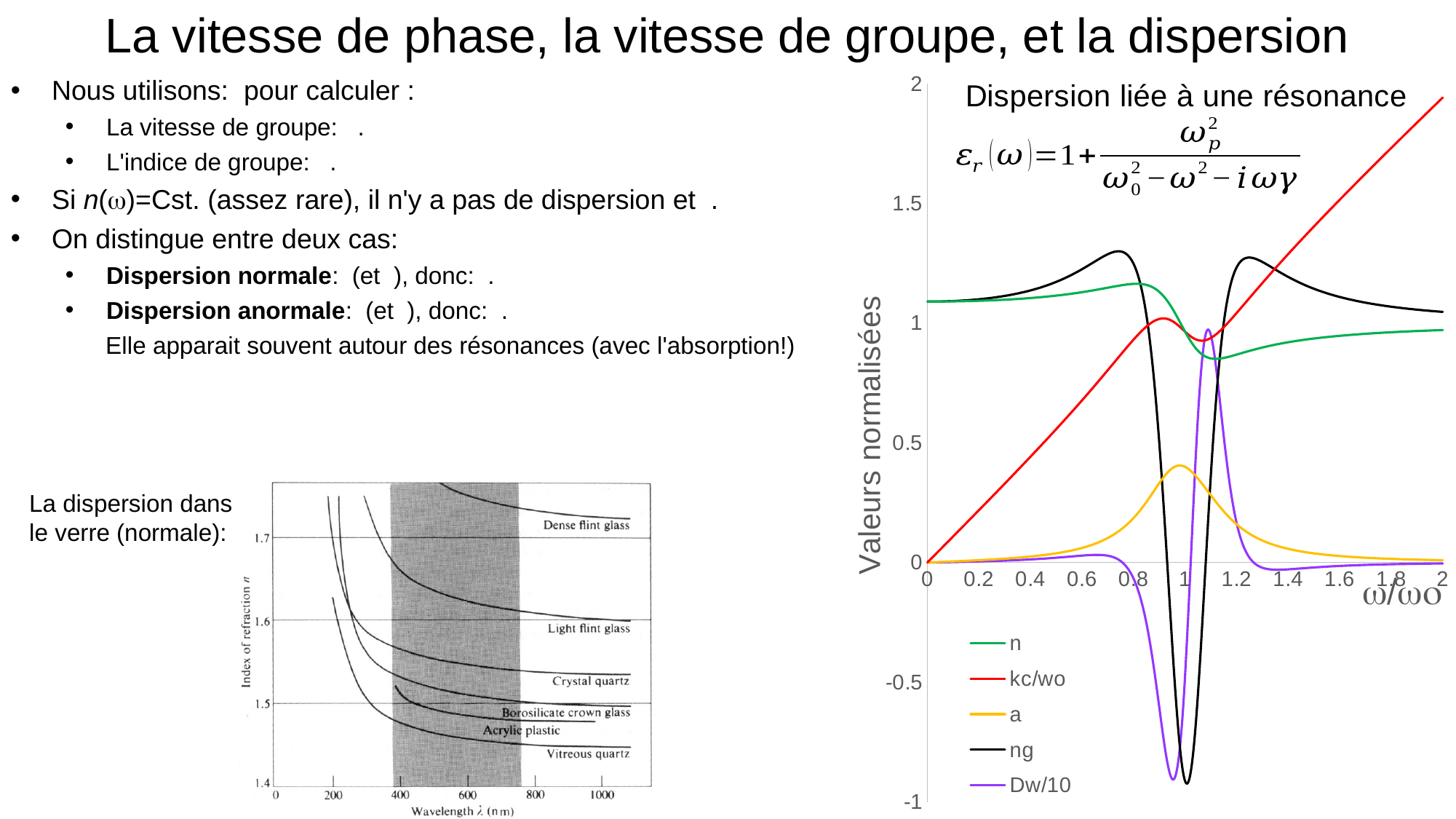
What kind of chart is the chart titled 'Dispersion liée à une résonance'? line chart In the bottom-left chart of index of refraction versus wavelength, does the index of refraction of Dense flint glass rise or fall as wavelength increases? fall In the chart titled 'Dispersion liée à une résonance', is the value of kc/wo at ω/ωo = 2 greater or less than 1.5? greater In the bottom-left chart of index of refraction versus wavelength, is the index of refraction of Vitreous quartz at 600 nm greater or less than 1.5? less In the chart titled 'Dispersion liée à une résonance', what colour is the ng series drawn in? black In the chart titled 'Dispersion liée à une résonance', does the kc/wo series rise or fall between ω/ωo = 0 and ω/ωo = 0.8? rise In the bottom-left chart of index of refraction versus wavelength, how many labelled material curves are shown? 6 In the chart titled 'Dispersion liée à une résonance', is the value of a at ω/ωo = 1 greater or less than 0.5? less In the chart titled 'Dispersion liée à une résonance', what is the label of the vertical axis? Valeurs normalisées In the chart titled 'Dispersion liée à une résonance', which series reaches the highest value on the chart? kc/wo In the chart titled 'Dispersion liée à une résonance', how many series does the legend list? 5 In the chart titled 'Dispersion liée à une résonance', what is the value of kc/wo at ω/ωo = 0? 0